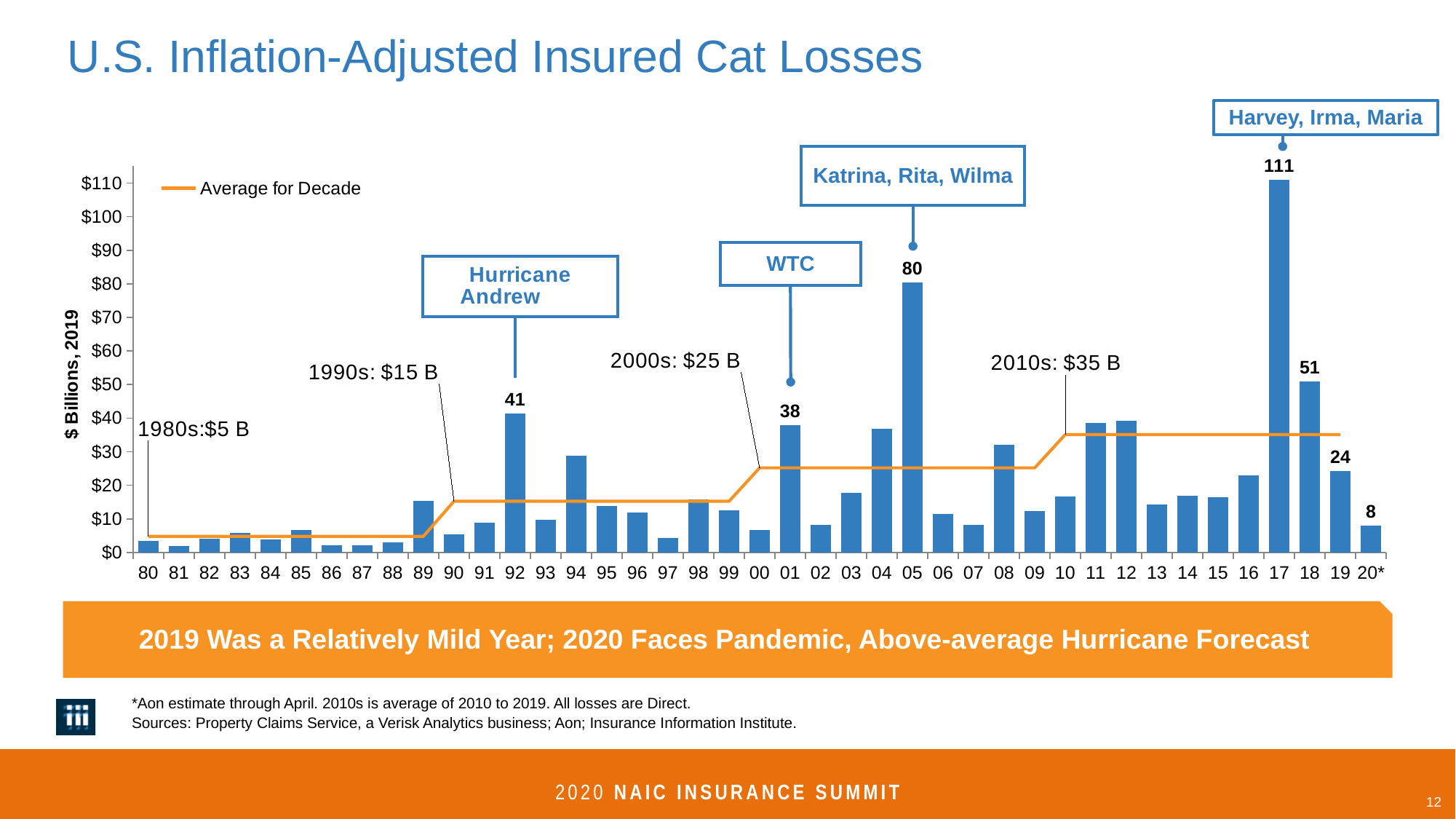
What is the difference between the values for 2017 and 2018? 60 Is the value for 2012 greater or less than $30? greater What is the value for 2005 (labeled 05)? 80 Which year has the highest insured cat losses? 17 What is the value for 2020 (labeled 20*)? 8 Is the value for 1986 greater or less than $10? less Which is larger, the value for 1992 or the value for 2001? 1992 What is the value for 2017 (labeled 17)? 111 What kind of chart is shown on the slide? combination bar and line chart What is the difference between the values for 2005 and 2001? 42 What is the value for 1992 (labeled 92)? 41 What is the average for the 2010s decade shown on the chart? $35 B